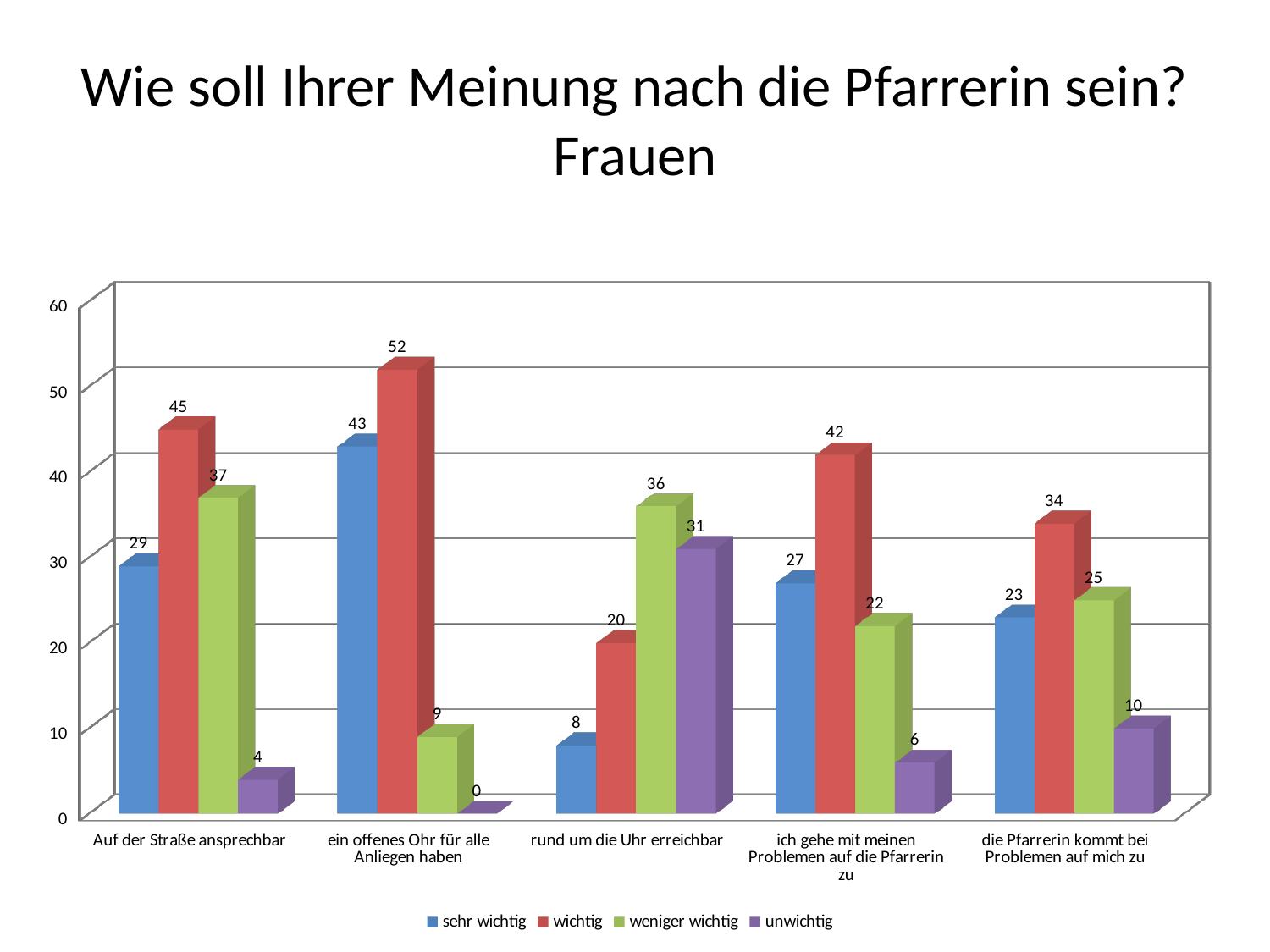
How many series does the legend list? 4 What is the value for "wichtig" in the category "ein offenes Ohr für alle Anliegen haben"? 52 What kind of chart is shown on the slide? bar chart Which colour represents the series "unwichtig" in the legend? purple Which category has the highest value for "sehr wichtig"? ein offenes Ohr für alle Anliegen haben What is the value for "sehr wichtig" in the category "die Pfarrerin kommt bei Problemen auf mich zu"? 23 What is the difference between "wichtig" and "sehr wichtig" in the category "Auf der Straße ansprechbar"? 16 What is the value for "weniger wichtig" in the category "ich gehe mit meinen Problemen auf die Pfarrerin zu"? 22 Which category has the lowest value for "unwichtig"? ein offenes Ohr für alle Anliegen haben Which is larger in the category "rund um die Uhr erreichbar": "weniger wichtig" or "wichtig"? weniger wichtig What is the value for "unwichtig" in the category "rund um die Uhr erreichbar"? 31 How many categories are shown on the x axis? 5